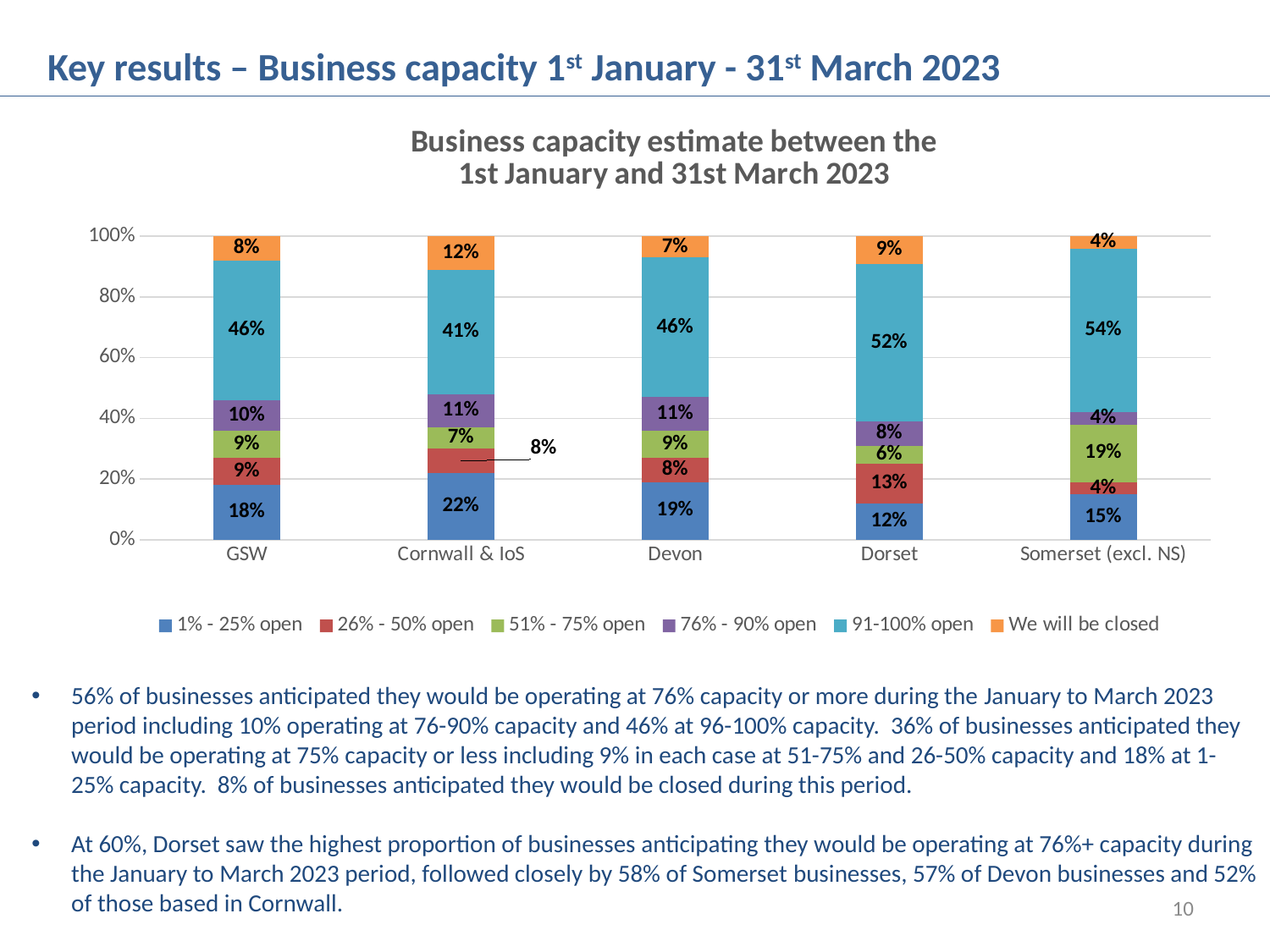
Which region has the highest '91-100% open' value? Somerset (excl. NS) How many regions (categories) are shown on the x axis of the chart? 5 What is the '26% - 50% open' value for Dorset? 13% What is the title of the chart? Business capacity estimate between the 1st January and 31st March 2023 Which region has the lowest 'We will be closed' value? Somerset (excl. NS) What is the 'We will be closed' value for Cornwall & IoS? 12% What is the difference in the '1% - 25% open' value between Cornwall & IoS and Dorset? 10 percentage points Which region has the highest '1% - 25% open' value? Cornwall & IoS How many series does the chart legend list? 6 What kind of chart is shown on the slide? Stacked bar chart What percentage of Dorset businesses anticipated being 91-100% open? 52% Which has the larger '51% - 75% open' value, Somerset (excl. NS) or GSW? Somerset (excl. NS)